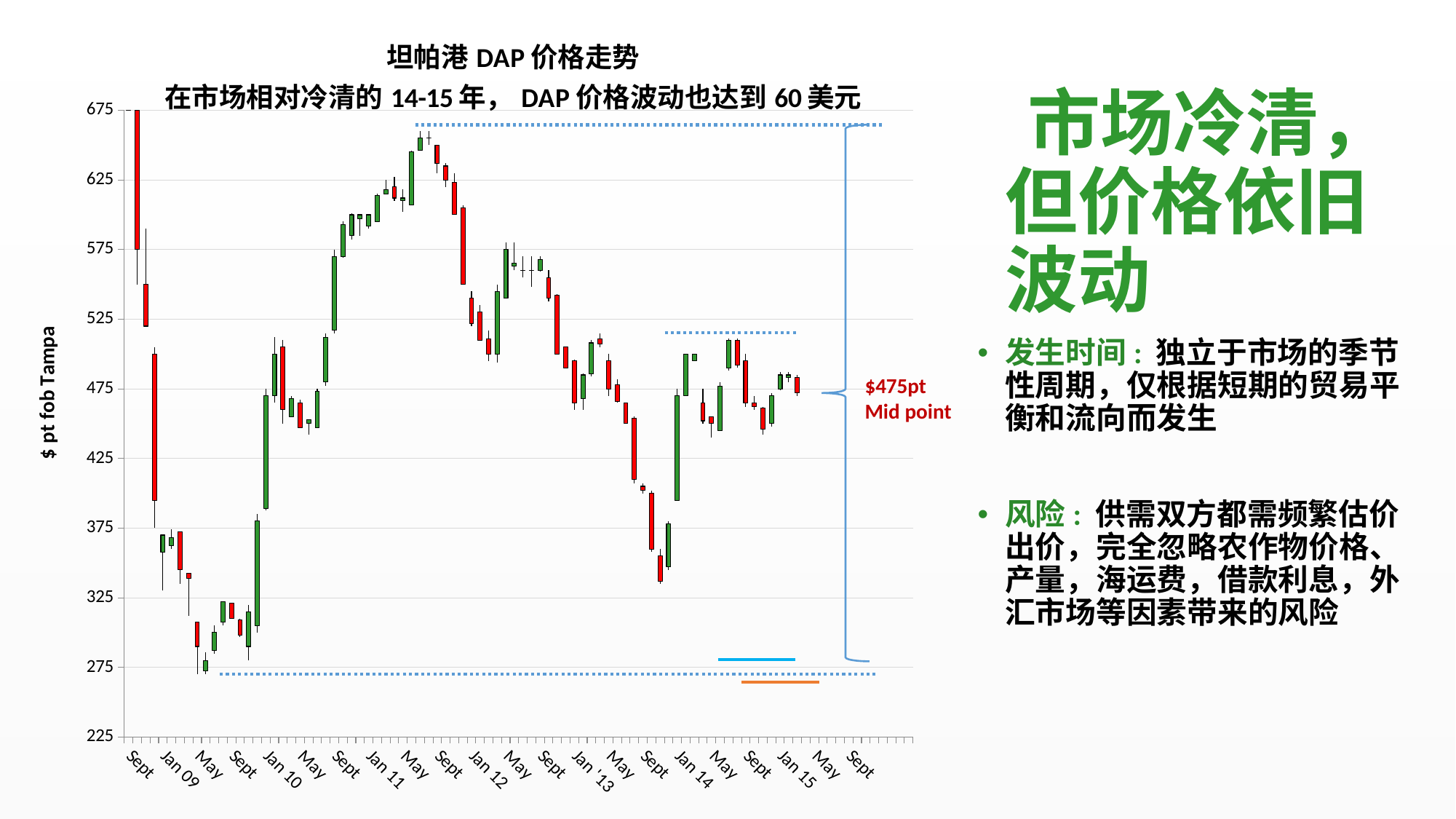
Is the DAP price around Sept 2013 greater or less than 425? less What mid-point price is annotated on the right side of the chart? $475pt Around which x-axis label does the DAP price reach its highest level? May (2011) What is the label on the vertical axis of the chart? $ pt fob Tampa What is the highest value shown on the vertical axis? 675 What is the title of the chart? 坦帕港 DAP 价格走势 Around which x-axis label does the DAP price reach its lowest level? May (2009) What is the lowest value shown on the vertical axis? 225 Does the DAP price rise or fall between Jan 10 and May 2011? rise What kind of chart is shown on the slide? candlestick (stock) chart Is the DAP price around May 2009 greater or less than 325? less